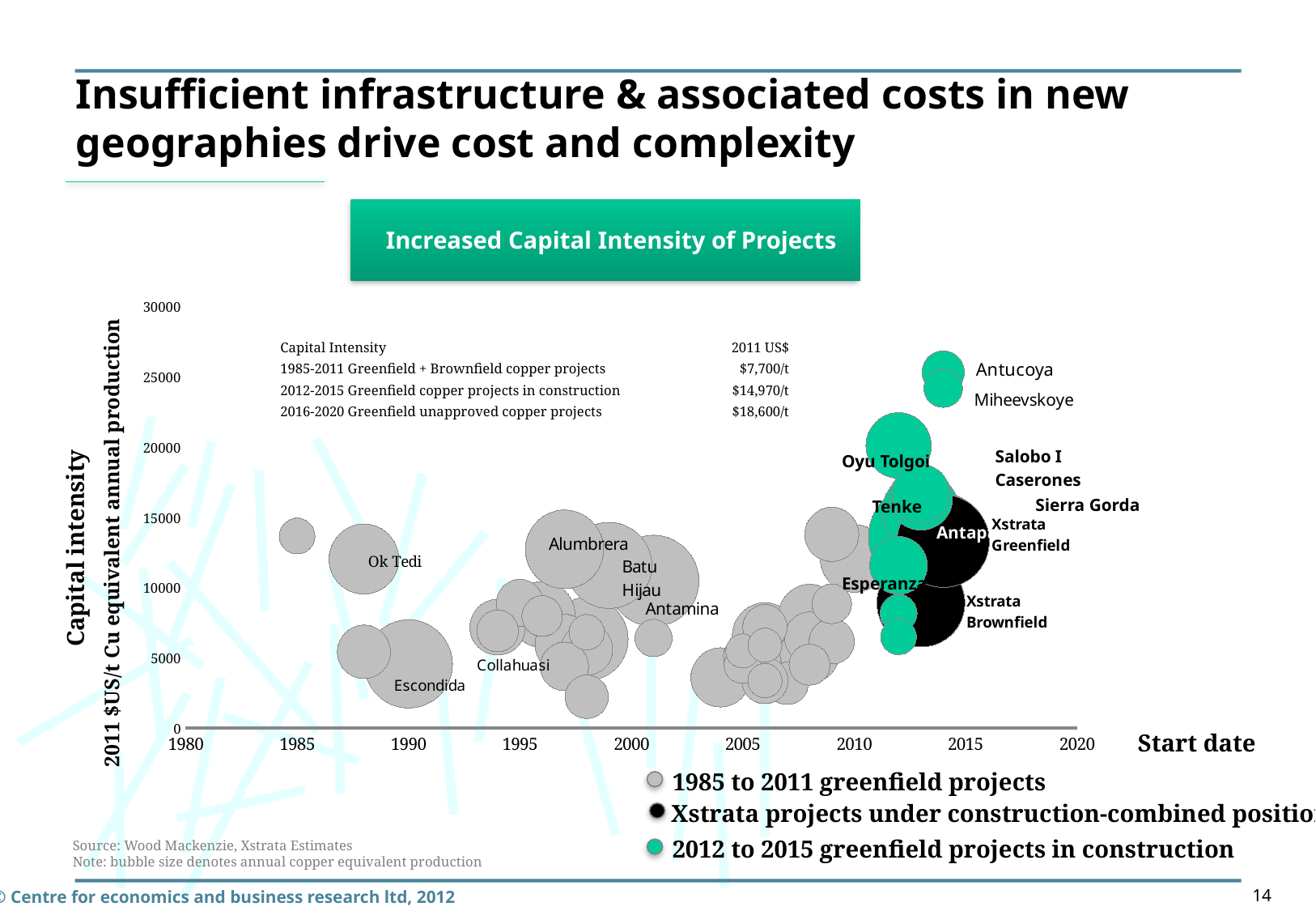
What is the title shown above the chart? Increased Capital Intensity of Projects What is the label of the x axis? Start date Is the capital intensity for Ok Tedi greater or less than 10000? greater Is the capital intensity for Escondida greater or less than 10000? less Which labelled project has the highest capital intensity on the chart? Antucoya How many entries does the chart legend list? 3 What kind of chart is shown on the slide? Bubble chart According to the text in the chart, what is the capital intensity of 2016-2020 greenfield unapproved copper projects? $18,600/t According to the text in the chart, what is the capital intensity of 1985-2011 greenfield + brownfield copper projects? $7,700/t According to the text in the chart, what is the capital intensity of 2012-2015 greenfield copper projects in construction? $14,970/t Which has the higher capital intensity, Antucoya or Escondida? Antucoya Is the capital intensity for Antucoya greater or less than 20000? greater